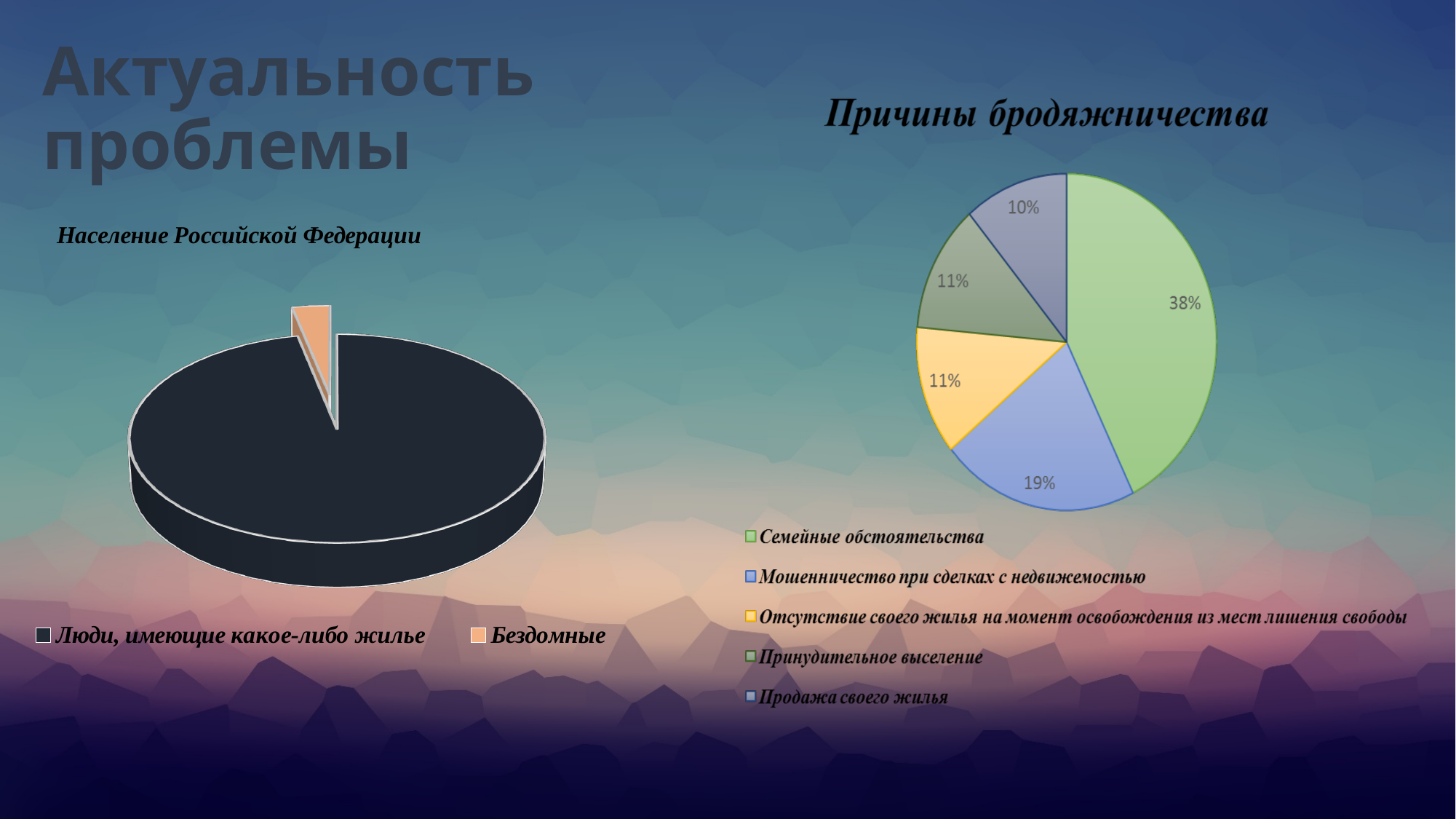
In the chart titled "Причины бродяжничества", what share is shown for "Принудительное выселение"? 11% In the chart titled "Причины бродяжничества", which cause has the largest share? Семейные обстоятельства In the chart titled "Причины бродяжничества", which is larger: the share for "Мошенничество при сделках с недвижимостью" or the share for "Продажа своего жилья"? Мошенничество при сделках с недвижимостью In the chart titled "Причины бродяжничества", what is the difference in percentage points between "Семейные обстоятельства" and "Мошенничество при сделках с недвижимостью"? 19 In the chart titled "Причины бродяжничества", what share is shown for "Мошенничество при сделках с недвижимостью"? 19% In the chart titled "Причины бродяжничества", what share is shown for "Семейные обстоятельства"? 38% How many categories does the legend of the chart titled "Население Российской Федерации" list? 2 In the chart titled "Население Российской Федерации", which category is the larger slice? Люди, имеющие какое-либо жилье In the chart titled "Причины бродяжничества", what share is shown for "Продажа своего жилья"? 10% How many slices does the chart titled "Причины бродяжничества" have? 5 In the chart titled "Причины бродяжничества", which cause has the smallest share? Продажа своего жилья What kind of chart is the one titled "Население Российской Федерации"? Pie chart